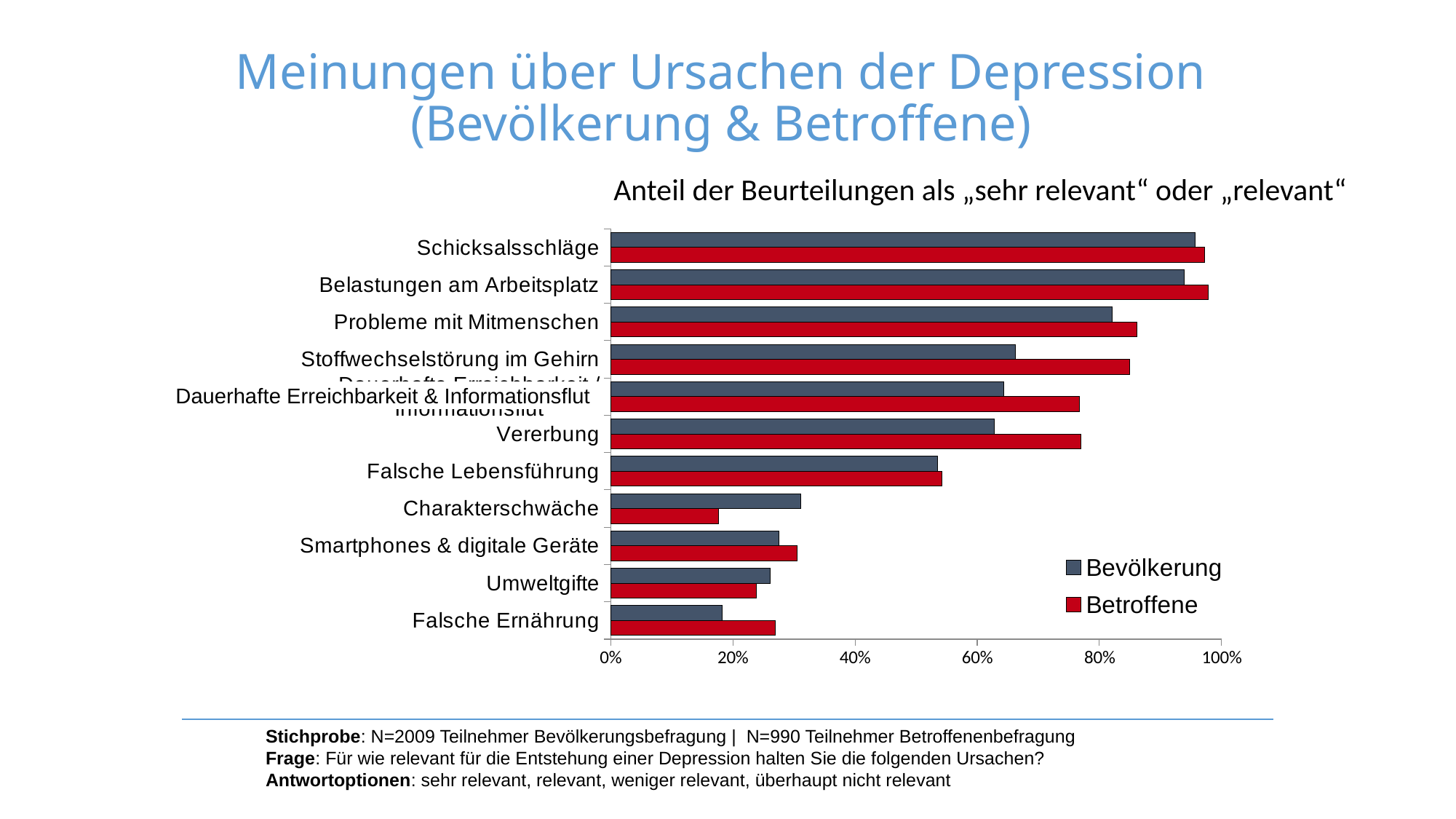
Is the Bevölkerung value for Stoffwechselstörung im Gehirn greater or less than 60%? greater Do the Bevölkerung values rise or fall going from the top category to the bottom category? fall Is the Betroffene value for Vererbung greater or less than 80%? less How many series does the legend list? 2 Which category has the lowest value for Bevölkerung? Falsche Ernährung Is the Betroffene value for Charakterschwäche greater or less than 20%? less For Charakterschwäche, which series has the larger value, Bevölkerung or Betroffene? Bevölkerung How many categories (causes) are shown on the chart? 11 For Stoffwechselstörung im Gehirn, which series has the larger value, Bevölkerung or Betroffene? Betroffene Which category has the lowest value for Betroffene? Charakterschwäche What kind of chart is shown on the slide? bar chart Which colour represents the Betroffene series in the legend? red